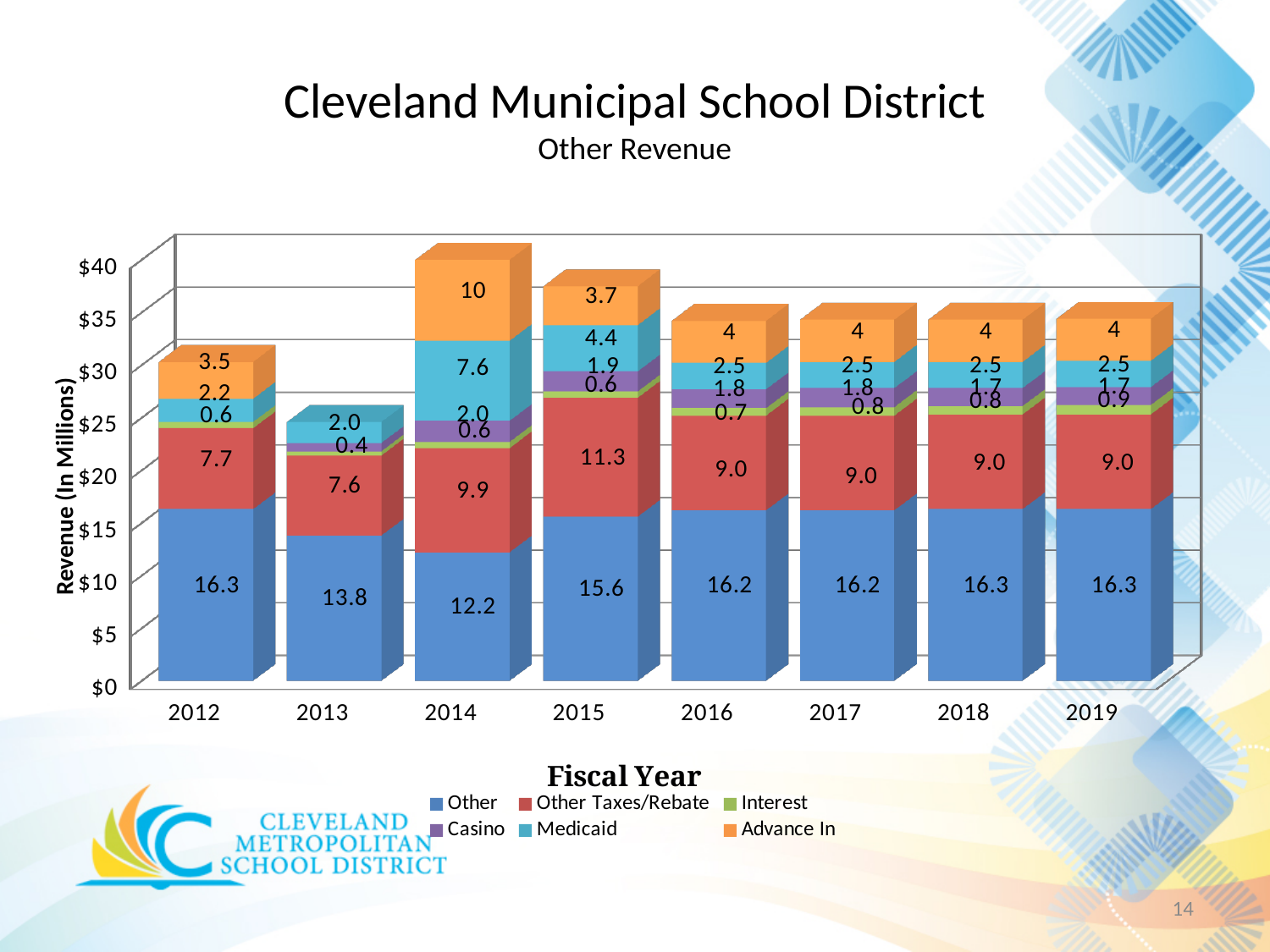
Which year has the larger Medicaid segment, 2014 or 2015? 2014 What is the value of the Other Taxes/Rebate segment for 2015? 11.3 In which fiscal year is the Other Taxes/Rebate segment the highest? 2015 What is the value of the Other segment for 2014? 12.2 In which fiscal year is the Other segment the lowest? 2014 What is the value of the Advance In segment for 2014? 10 What kind of chart is shown on the slide? Stacked bar chart What is the value of the Medicaid segment for 2016? 2.5 What is the difference between the Other segment in 2012 and in 2013? 2.5 What is the title of the x axis? Fiscal Year How many series does the legend list? 6 How many fiscal years are shown on the x axis? 8